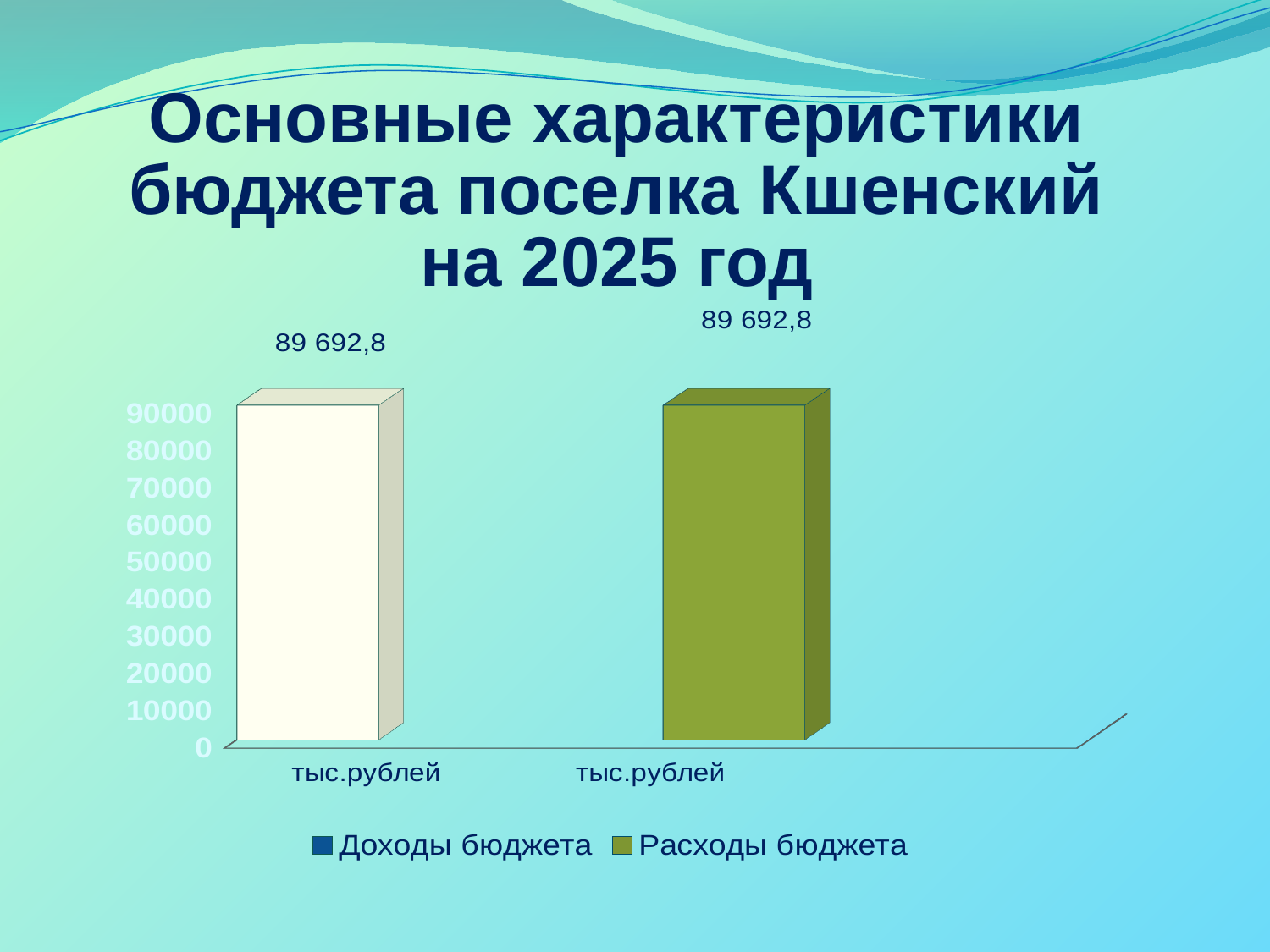
How many bars are plotted on the chart? 2 How many series does the legend list? 2 What unit label appears under each bar on the x axis? тыс.рублей What is the value shown for Доходы бюджета? 89 692,8 What is the highest tick value shown on the vertical axis? 90000 What are the two series named in the legend? Доходы бюджета, Расходы бюджета Is the value for Доходы бюджета greater or less than 80000? greater Is the value for Расходы бюджета greater or less than 50000? greater What is the difference between the values for Доходы бюджета and Расходы бюджета? 0 What kind of chart is shown on the slide? bar chart What is the value shown for Расходы бюджета? 89 692,8